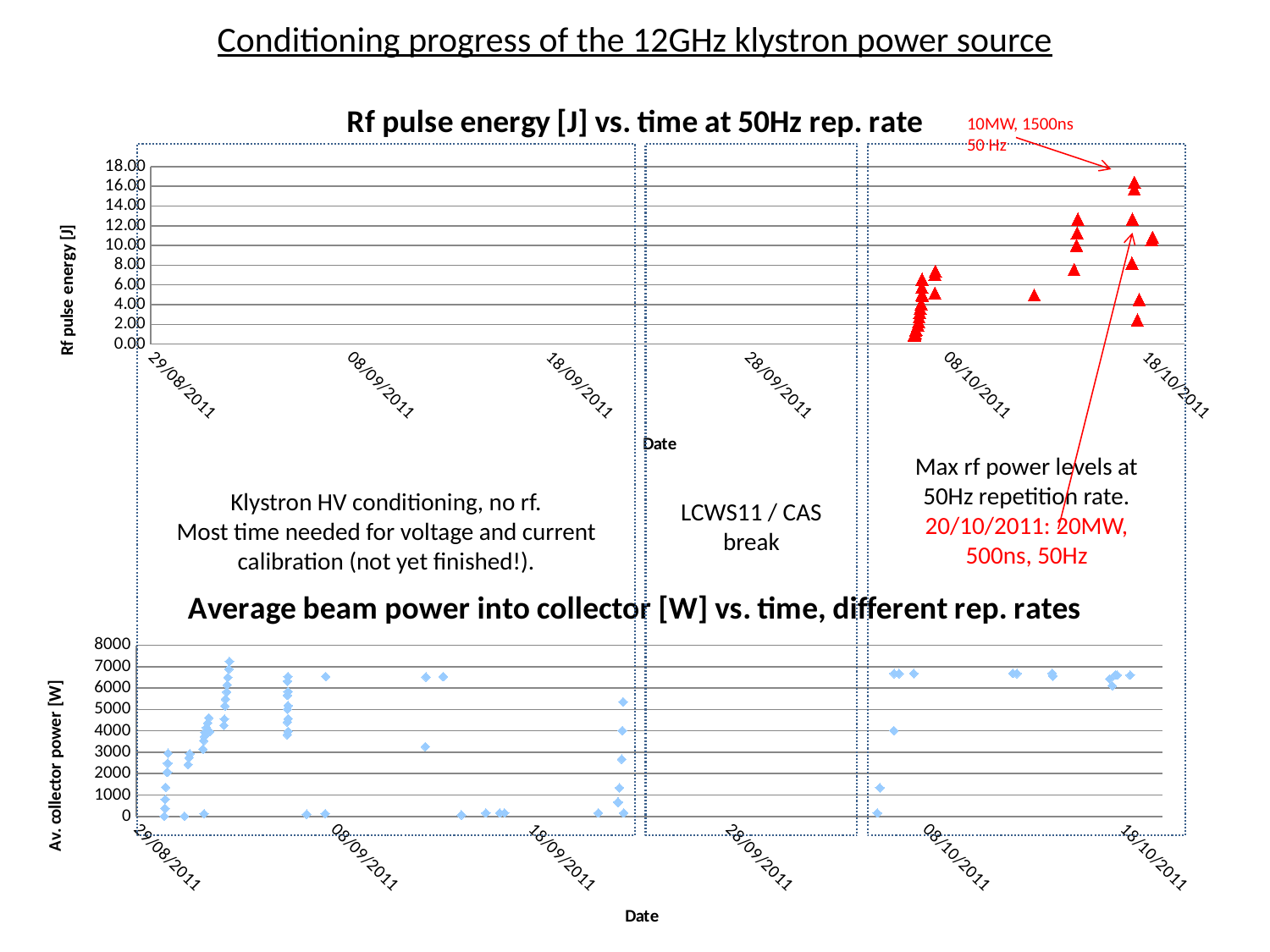
What kind of chart is the bottom chart titled 'Average beam power into collector [W] vs. time, different rep. rates'? scatter chart What is the maximum value shown on the vertical axis of the bottom chart? 8000 In the top chart, is the highest plotted rf pulse energy value greater or less than 14.00? greater In the bottom chart, is the highest plotted collector power value greater or less than 6000? greater In the bottom chart, what is the label of the vertical axis? Av. collector power [W] How many date labels are shown on the horizontal axis of the top chart? 6 In the top chart, do the plotted rf pulse energy values generally rise or fall from 08/10/2011 to 18/10/2011? rise What kind of chart is the top chart titled 'Rf pulse energy [J] vs. time at 50Hz rep. rate'? scatter chart In the bottom chart, is the highest plotted collector power value greater or less than 8000? less What is the maximum value shown on the vertical axis of the top chart? 18.00 In the top chart, what is the label of the vertical axis? Rf pulse energy [J]